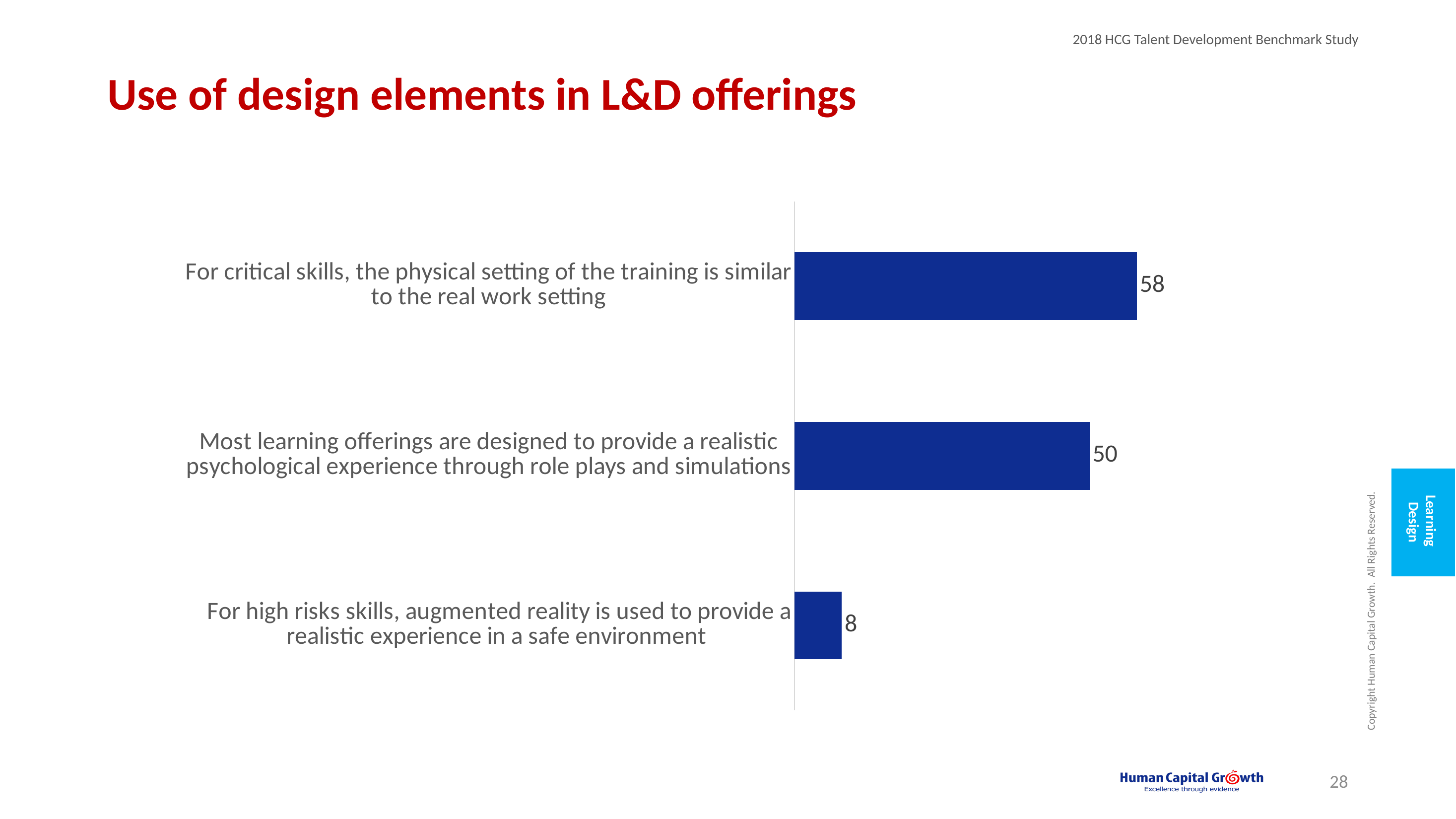
Which is larger: the value for role plays and simulations or the value for augmented reality for high risk skills? Most learning offerings are designed to provide a realistic psychological experience through role plays and simulations What is the difference between the value for the physical setting being similar to the real work setting and the value for role plays and simulations? 8 What is the value for 'For high risks skills, augmented reality is used to provide a realistic experience in a safe environment'? 8 How many categories are shown in the chart? 3 What kind of chart is shown on the slide? Bar chart What is the value for 'For critical skills, the physical setting of the training is similar to the real work setting'? 58 What is the title of the slide containing the chart? Use of design elements in L&D offerings What colour are the bars in the chart? Dark blue Which category has the highest value? For critical skills, the physical setting of the training is similar to the real work setting What is the difference between the value for the physical setting being similar to the real work setting and the value for augmented reality being used for high risk skills? 50 What is the value for 'Most learning offerings are designed to provide a realistic psychological experience through role plays and simulations'? 50 Which category has the lowest value? For high risks skills, augmented reality is used to provide a realistic experience in a safe environment